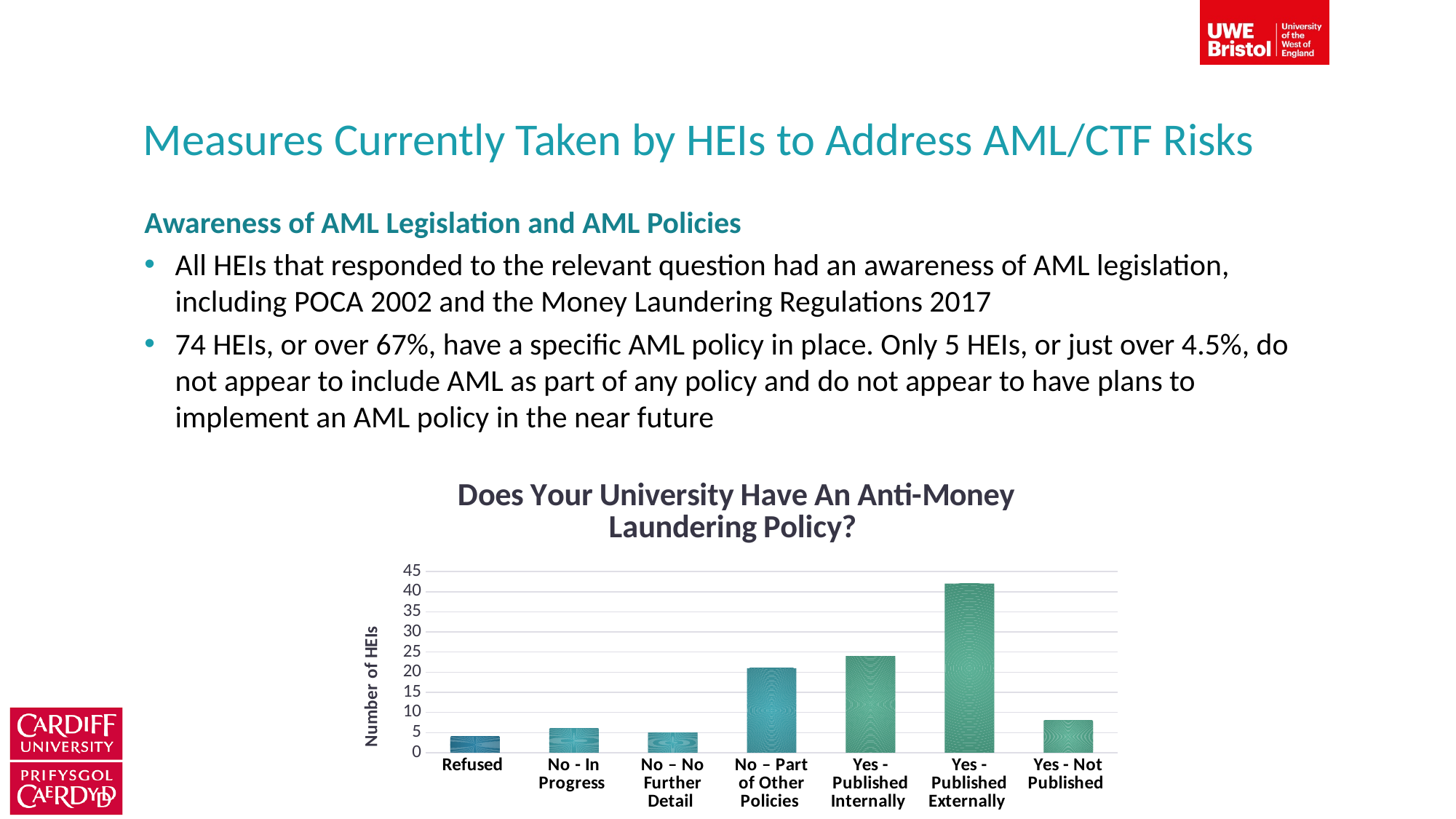
Is the value for Yes - Published Internally greater or less than 20? greater Which is larger, the value for Yes - Published Externally or the value for Yes - Published Internally? Yes - Published Externally What kind of chart is shown on the slide? bar chart How many categories are shown on the x axis of the chart? 7 Is the value for Yes - Not Published greater or less than 10? less Is the value for Refused greater or less than 10? less Which is larger, the value for No – Part of Other Policies or the value for Yes - Not Published? No – Part of Other Policies What is the label on the vertical axis of the chart? Number of HEIs What is the title of the chart? Does Your University Have An Anti-Money Laundering Policy? Which category has the highest number of HEIs? Yes - Published Externally